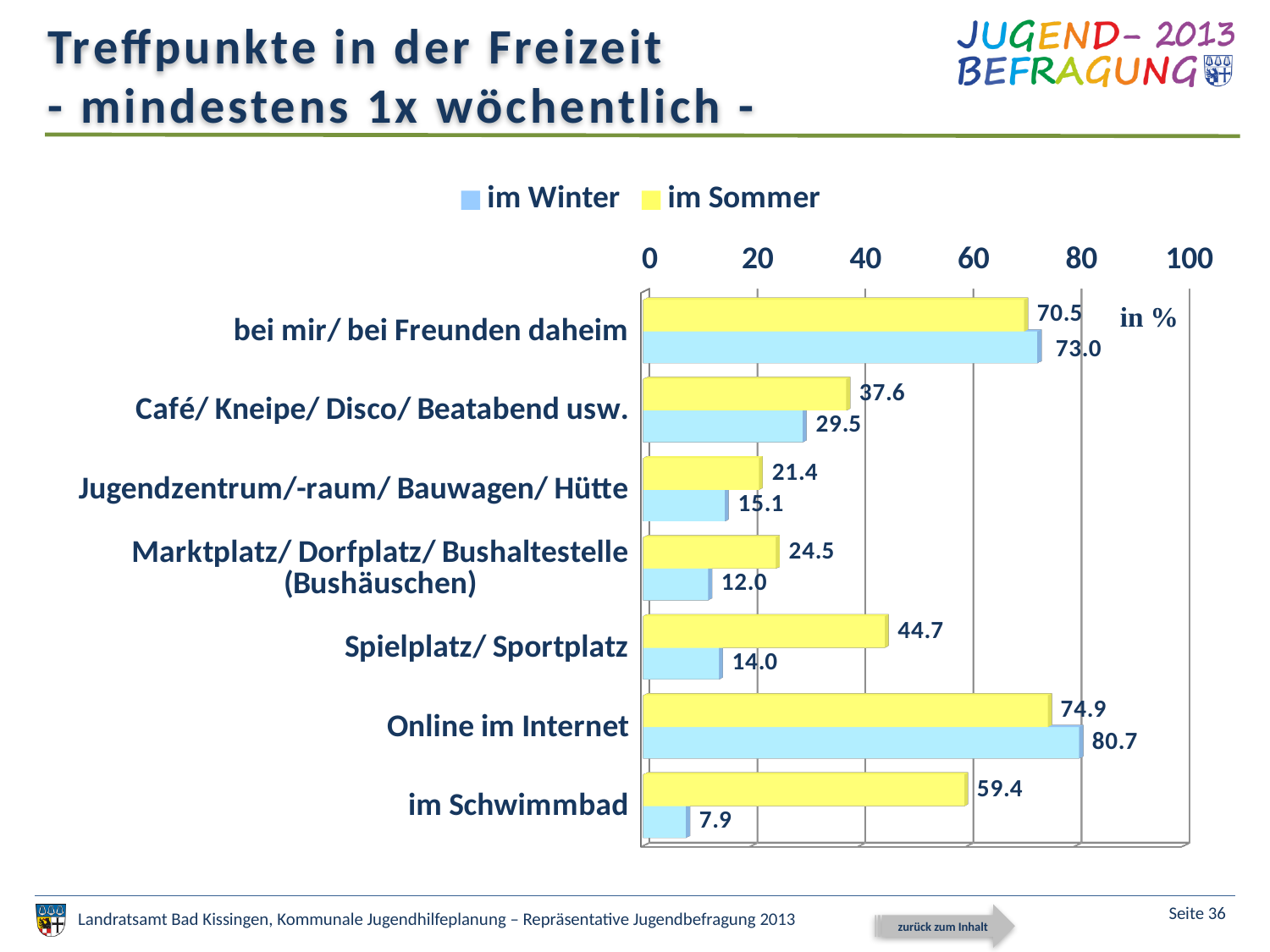
What is the value for 'Online im Internet' in the 'im Winter' series? 80.7 Which colour represents the 'im Sommer' series? yellow Which category has the highest value in the 'im Sommer' series? Online im Internet What is the difference between the 'im Sommer' and 'im Winter' values for 'im Schwimmbad'? 51.5 What is the value for 'Spielplatz/ Sportplatz' in the 'im Winter' series? 14.0 For 'Café/ Kneipe/ Disco/ Beatabend usw.', which series has the larger value, 'im Winter' or 'im Sommer'? im Sommer What is the value for 'im Schwimmbad' in the 'im Sommer' series? 59.4 What kind of chart is shown on the slide? bar chart Is the 'im Sommer' value for 'Spielplatz/ Sportplatz' greater or less than 40? greater Which category has the lowest value in the 'im Winter' series? im Schwimmbad How many series does the legend list? 2 How many categories are shown on the chart? 7